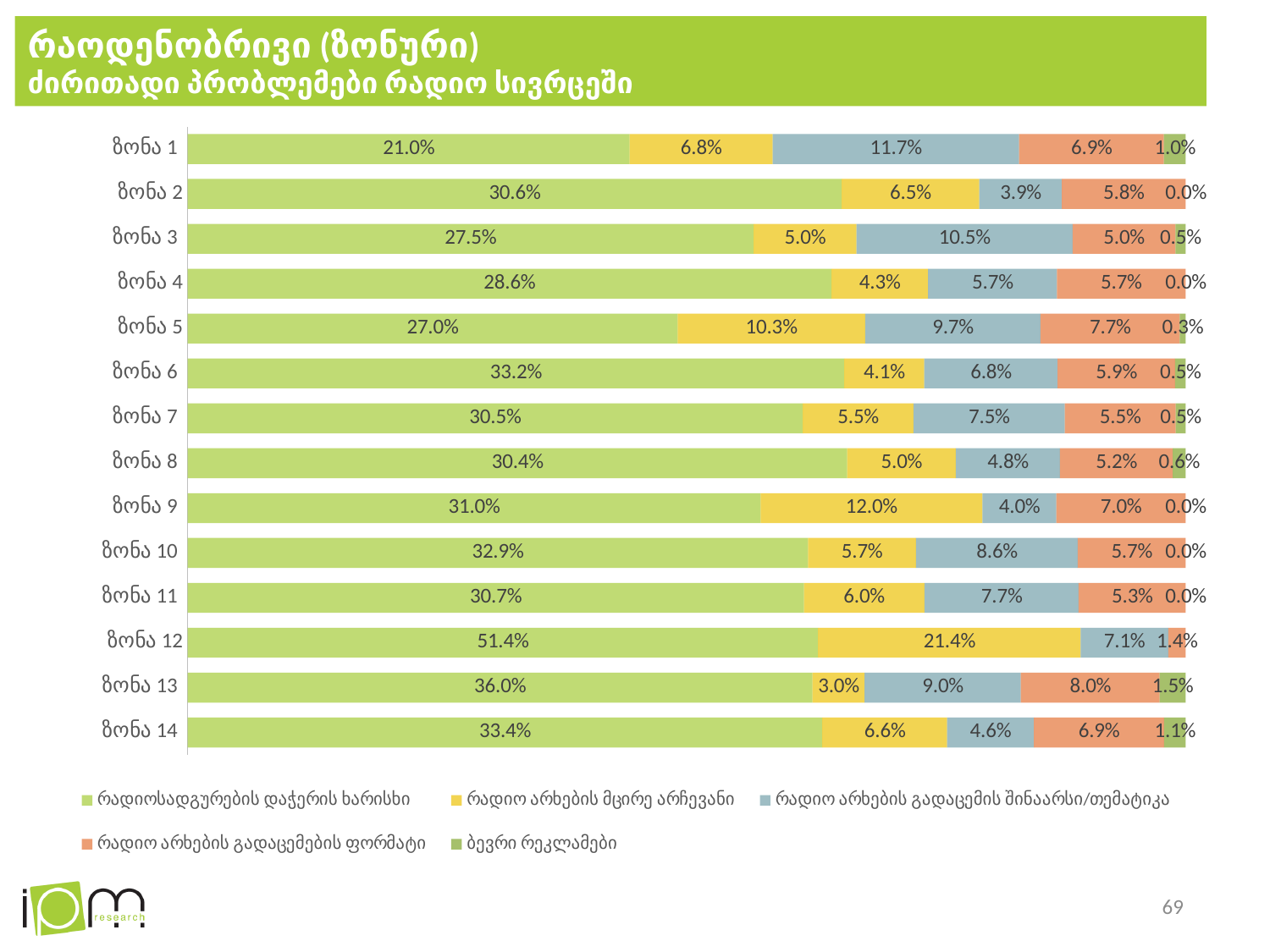
How many zones are shown in the chart? 14 What is the value for რადიო არხების მცირე არჩევანი in ზონა 9? 12.0% Which zone has the lowest value for რადიოსადგურების დაჭერის ხარისხი? ზონა 1 Which zone has the highest value for რადიოსადგურების დაჭერის ხარისხი? ზონა 12 What is the value for რადიო არხების გადაცემის შინაარსი/თემატიკა in ზონა 3? 10.5% What is the difference between the რადიოსადგურების დაჭერის ხარისხი values for ზონა 12 and ზონა 1? 30.4 percentage points How many series does the legend list? 5 What is the value for ბევრი რეკლამები in ზონა 13? 1.5% Which is larger: the რადიო არხების მცირე არჩევანი value for ზონა 5 or for ზონა 13? ზონა 5 What is the total of the stacked bar for ზონა 13? 57.5% What is the value for რადიოსადგურების დაჭერის ხარისხი in ზონა 1? 21.0% What kind of chart is shown on the slide? Stacked bar chart